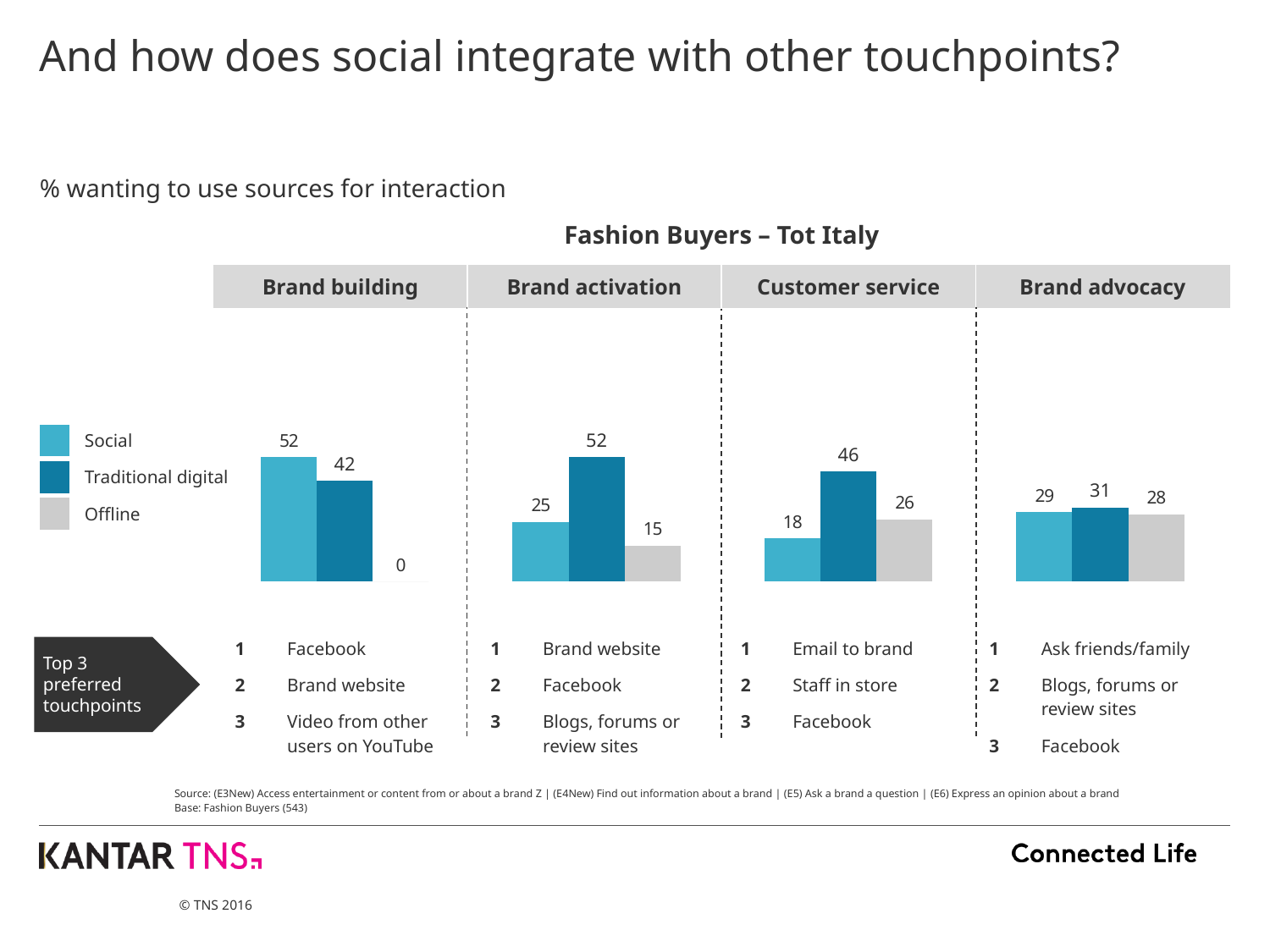
In the Brand activation chart, which source has the lowest value? Offline In the Customer service chart, what is the value for Offline? 26 How many series does the legend list? 3 In the Brand building chart, what is the value for Offline? 0 In the Brand activation chart, which is larger, Social or Offline? Social What kind of chart is used to show the % wanting to use sources for interaction? Bar chart In the Brand activation chart, what is the value for Traditional digital? 52 In the Brand advocacy chart, what is the value for Social? 29 In the Brand building chart, what is the difference between the Social and Traditional digital values? 10 In the Customer service chart, what is the difference between the Traditional digital and Social values? 28 In the Brand building chart, what is the value for Social? 52 In the Customer service chart, which source has the highest value? Traditional digital